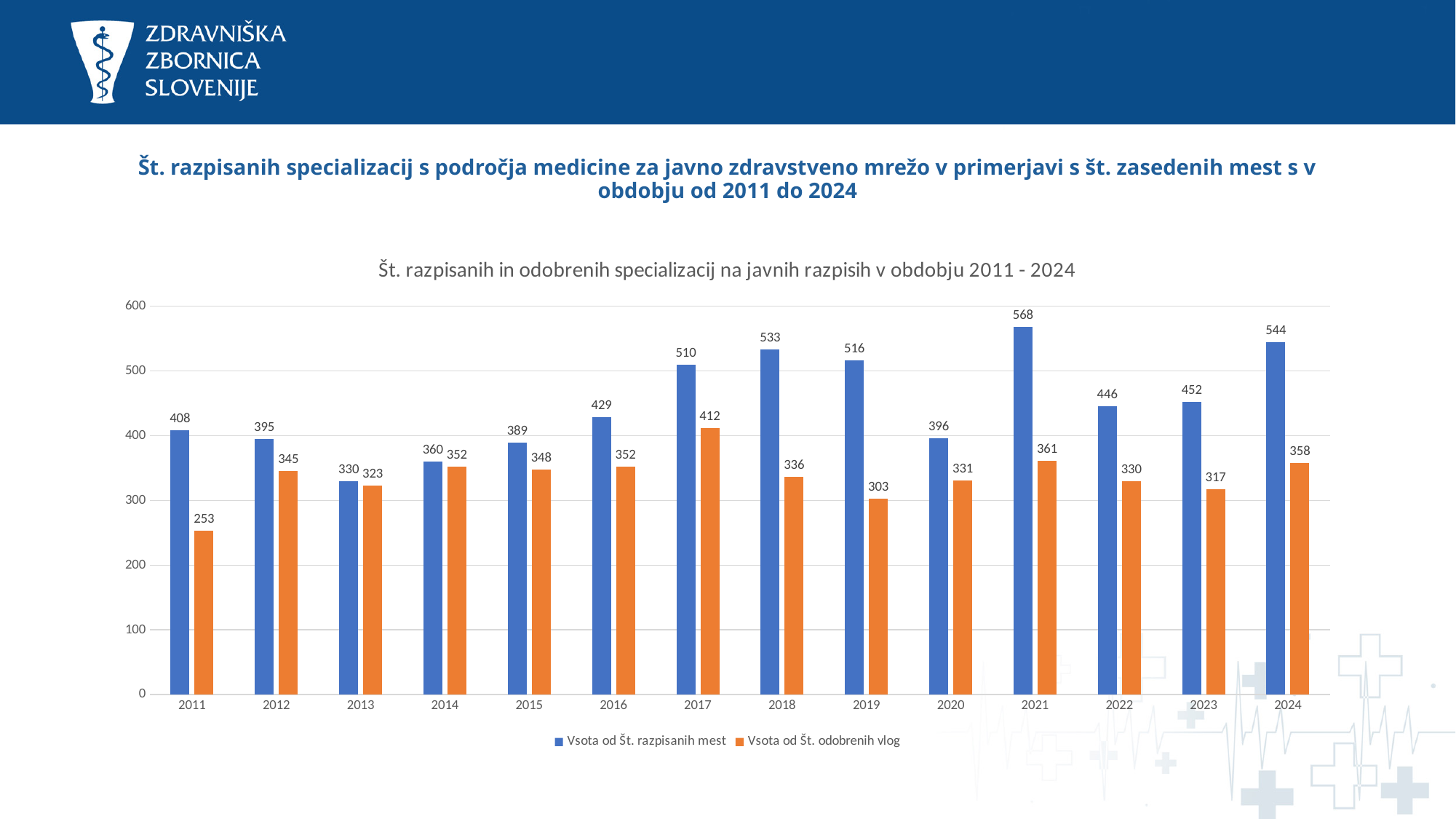
How many series does the chart legend list? 2 What kind of chart is shown on the slide? bar chart How many years are shown on the x axis of the chart? 14 What is the value of 'Vsota od Št. odobrenih vlog' for 2011? 253 What is the difference between 'Vsota od Št. razpisanih mest' and 'Vsota od Št. odobrenih vlog' in 2019? 213 In which year is 'Vsota od Št. odobrenih vlog' the lowest? 2011 Which is larger in 2013: 'Vsota od Št. razpisanih mest' or 'Vsota od Št. odobrenih vlog'? Vsota od Št. razpisanih mest Is the value of 'Vsota od Št. razpisanih mest' for 2018 greater or less than 500? greater What is the value of 'Vsota od Št. razpisanih mest' for 2021? 568 In which year is 'Vsota od Št. razpisanih mest' the highest? 2021 What is the value of 'Vsota od Št. odobrenih vlog' for 2017? 412 What is the title of the chart? Št. razpisanih in odobrenih specializacij na javnih razpisih v obdobju 2011 - 2024